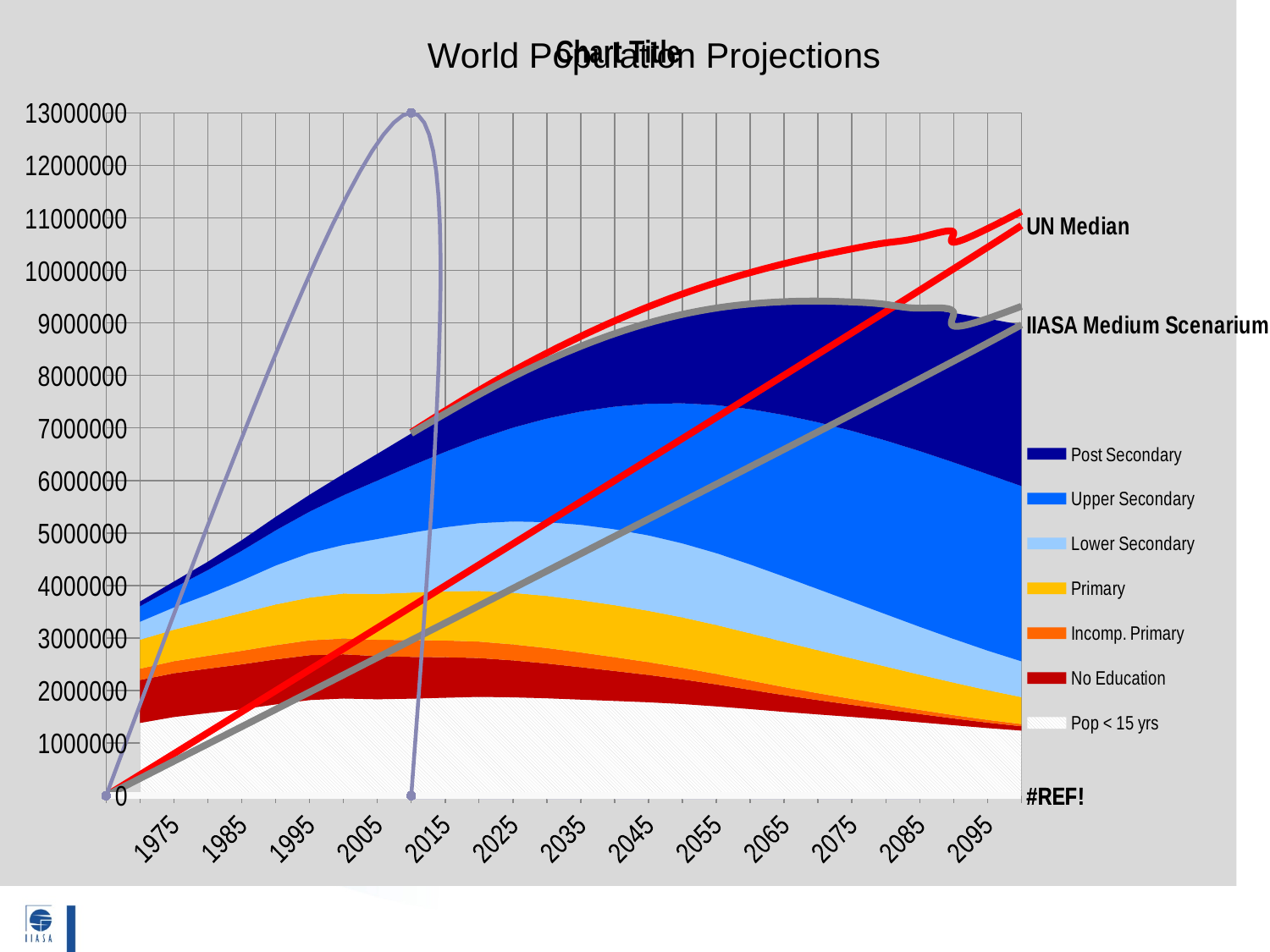
Is the Pop < 15 yrs area at 2095 greater or less than 1000000? greater How many series does the legend list? 7 What is the highest value shown on the y axis? 13000000 Is the top of the stacked area at 2065 greater or less than 9000000? greater Which legend entry is listed last? Pop < 15 yrs Does the UN Median line generally rise or fall from 1975 to 2095? rise What is the first year label on the x axis? 1975 What kind of chart is shown on the slide? Area chart (stacked area with overlaid lines) Does the Post Secondary band get thicker or thinner from 1975 to 2095? thicker How many year labels are shown along the x axis? 13